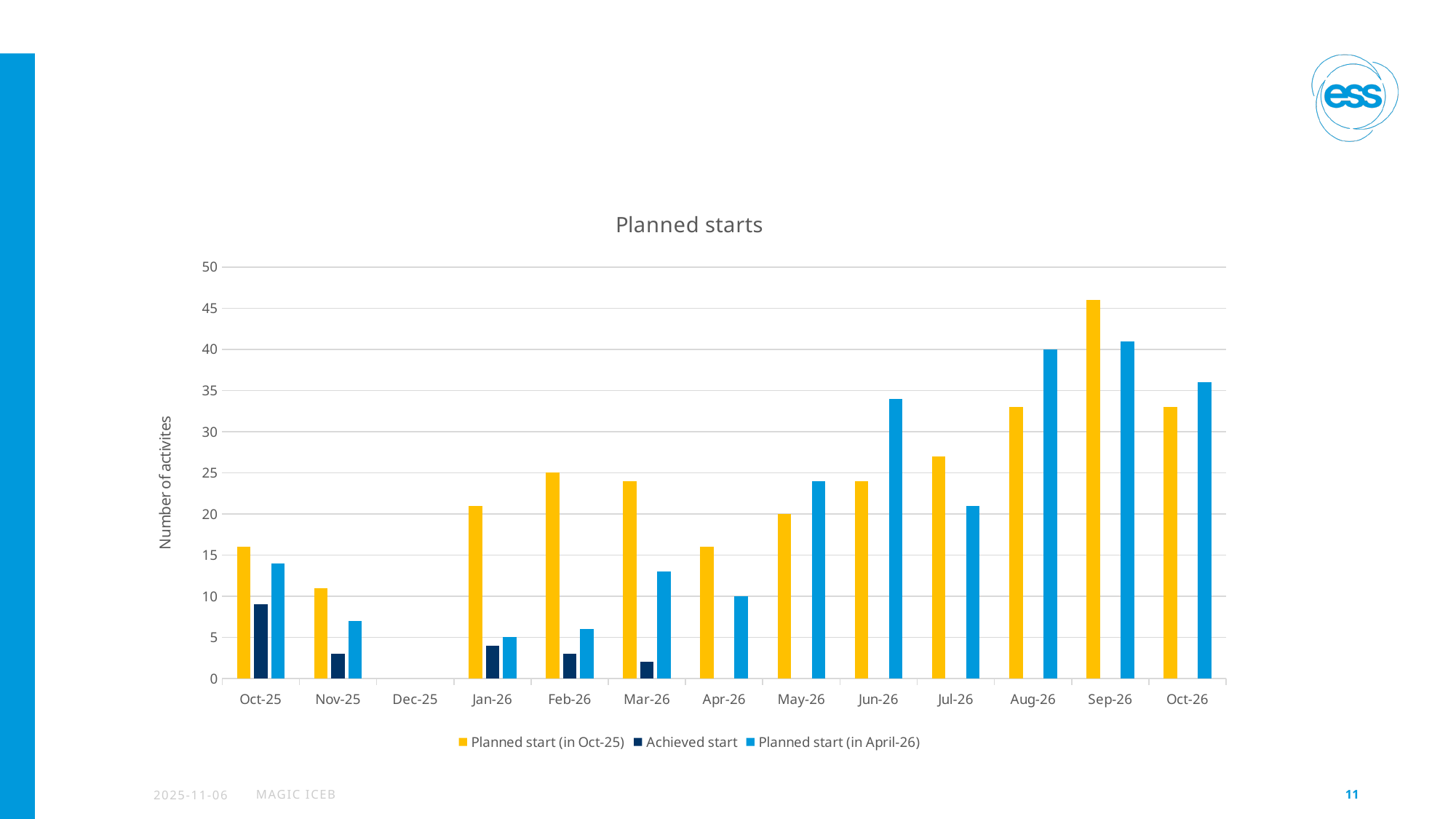
For Jul-26, which is larger: Planned start (in Oct-25) or Planned start (in April-26)? Planned start (in Oct-25) What is the value of Planned start (in Oct-25) for May-26? 20 How many months are shown on the x axis? 13 Is the value of Achieved start for Oct-25 greater or less than 10? less What is the title of the chart? Planned starts How many series does the legend list? 3 Which month has the tallest bar in the chart? Sep-26 What is the value of Planned start (in April-26) for Aug-26? 40 What kind of chart is shown on the slide? bar chart Is the value of Planned start (in Oct-25) for Sep-26 greater or less than 45? greater Which month has no bars at all? Dec-25 For Jun-26, which is larger: Planned start (in Oct-25) or Planned start (in April-26)? Planned start (in April-26)